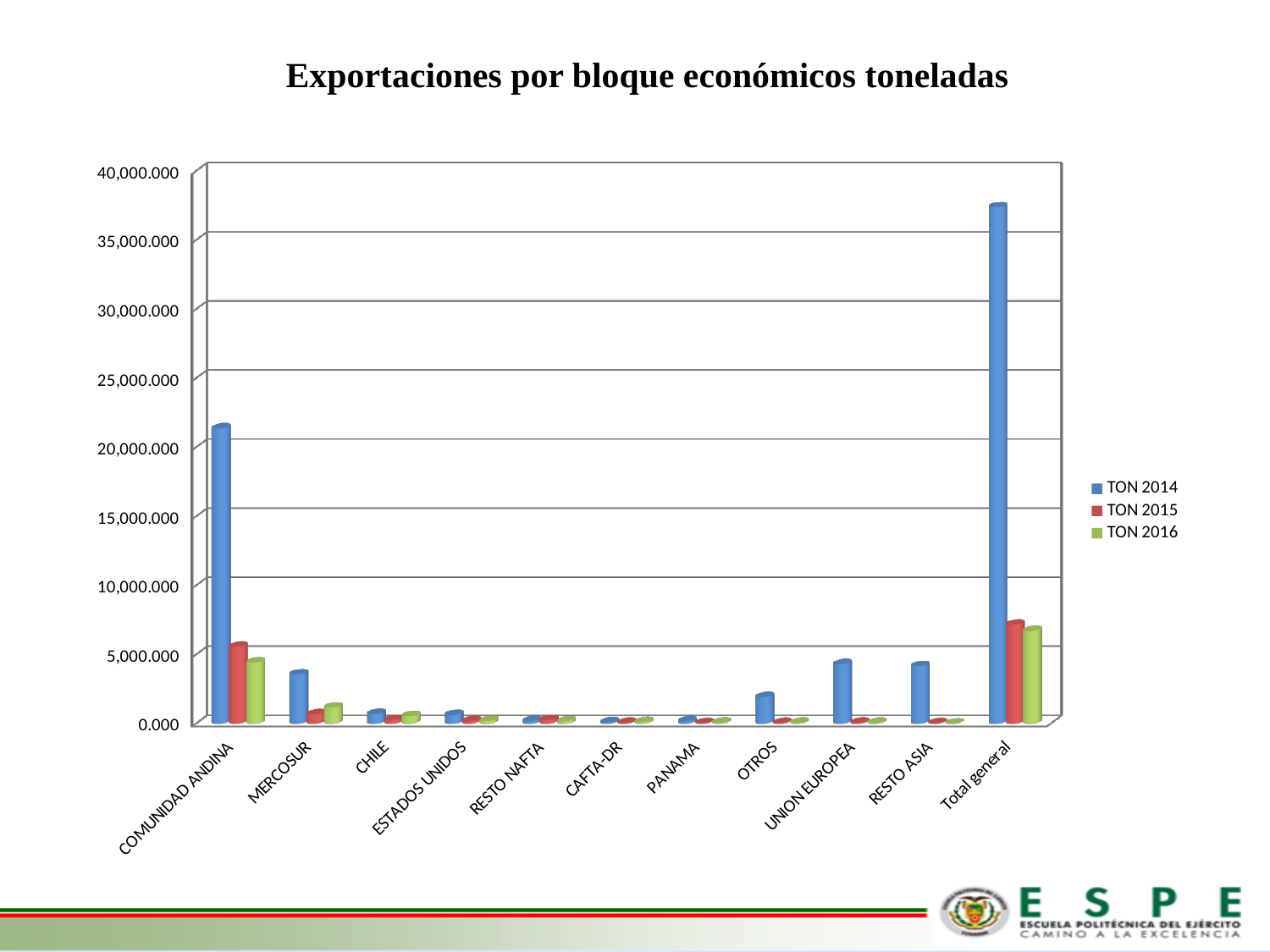
What kind of chart is shown on the slide? Bar chart How many categories are shown on the x axis? 11 Which category has the highest TON 2014 value? Total general Is the TON 2015 value for Total general greater or less than 5,000.000? greater For COMUNIDAD ANDINA, which is larger: TON 2014 or TON 2015? TON 2014 How many series does the legend list? 3 Which has the larger TON 2014 value: MERCOSUR or OTROS? MERCOSUR Is the TON 2014 value for COMUNIDAD ANDINA greater or less than 20,000.000? greater Excluding Total general, which economic bloc has the highest TON 2014 value? COMUNIDAD ANDINA Is the TON 2014 value for Total general greater or less than 35,000.000? greater What is the title of the chart? Exportaciones por bloque económicos toneladas